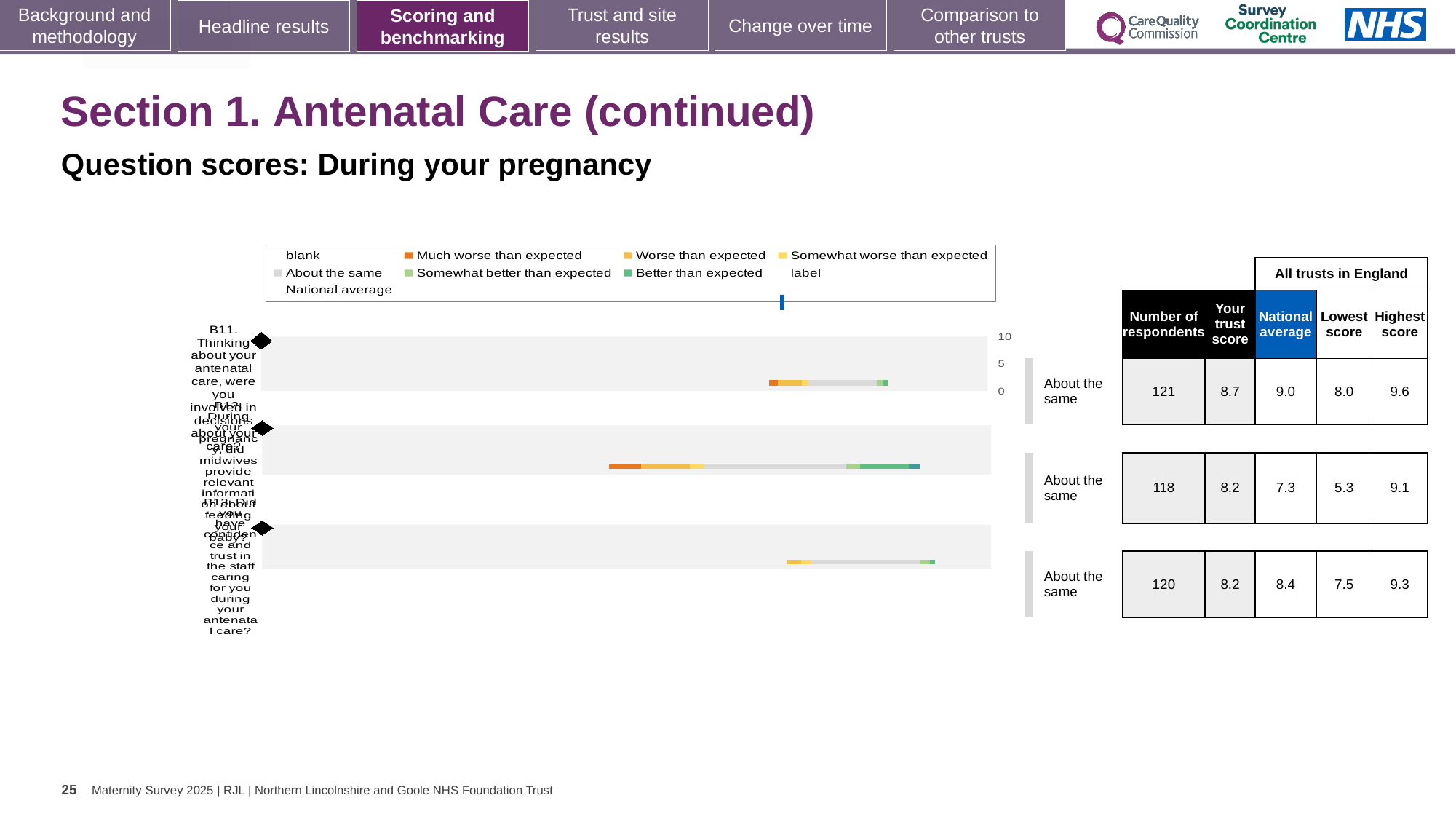
What is the difference between the highest score and the lowest score for question B12? 3.8 What is the number of respondents for question B11? 121 Which question has the lowest 'Lowest score' across all trusts in England? B12 In the chart legend, what colour represents 'Much worse than expected'? orange What benchmark category is shown for question B13? About the same What kind of chart is used to show the question scores on this slide? bar chart What is the subtitle describing the chart on this slide? Question scores: During your pregnancy What is the difference between the national average for B13 and the national average for B12? 1.1 What is the trust score for question B12? 8.2 Which question has the highest national average? B11 Which has the higher trust score, question B11 or question B13? B11 How many questions (bars) are plotted in the chart? 3